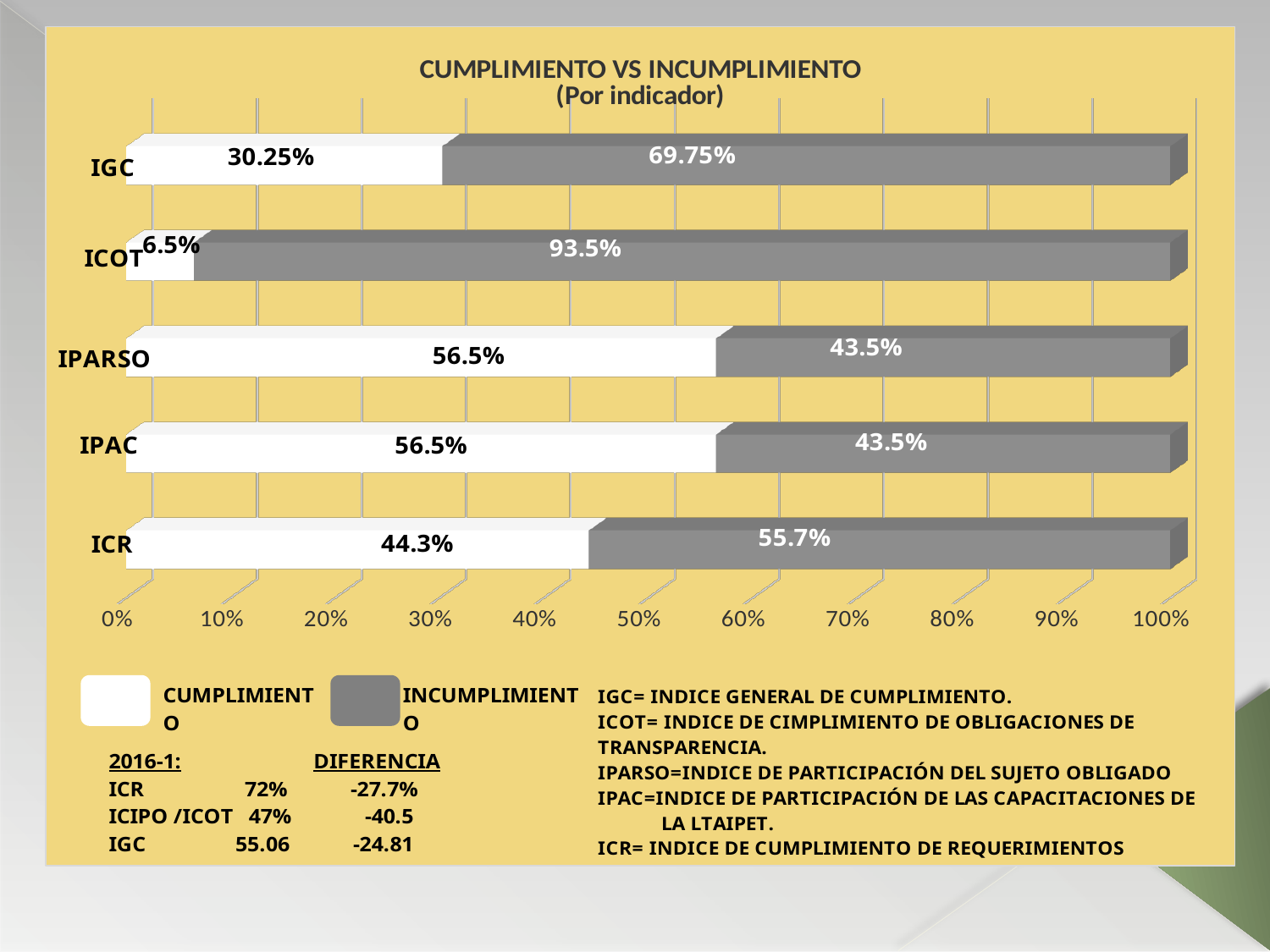
Which indicator has the highest INCUMPLIMIENTO value? ICOT What kind of chart is shown on the slide? Stacked bar chart What is the difference between the INCUMPLIMIENTO and CUMPLIMIENTO values for IGC? 39.5% What is the INCUMPLIMIENTO value for ICOT? 93.5% What is the total of the stacked bar for IPARSO? 100% How many indicators are shown on the chart? 5 What is the CUMPLIMIENTO value for ICR? 44.3% How many series does the legend list? 2 Which is larger for ICR: the CUMPLIMIENTO value or the INCUMPLIMIENTO value? INCUMPLIMIENTO What is the INCUMPLIMIENTO value for IPAC? 43.5% What is the CUMPLIMIENTO value for IGC? 30.25% Which indicator has the lowest CUMPLIMIENTO value? ICOT